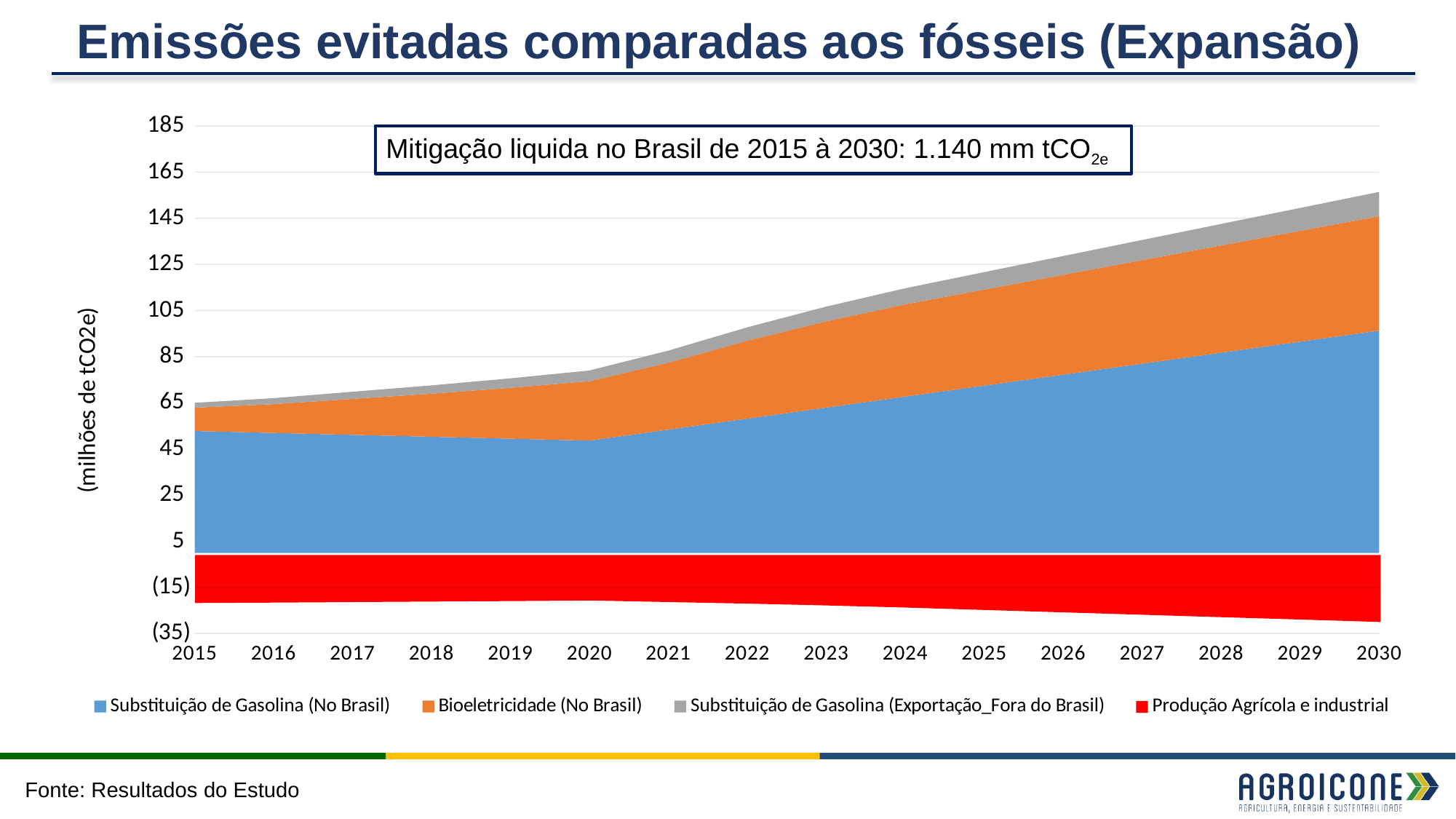
Is the value for Substituição de Gasolina (No Brasil) in 2030 greater or less than 85? greater Is the top of the stacked positive areas in 2020 greater or less than 65? greater What is the first year shown on the x axis? 2015 Is the top of the stacked positive areas in 2030 greater or less than 145? greater How many series does the legend list? 4 According to the text box on the chart, what is the net mitigation in Brazil from 2015 to 2030? 1.140 mm tCO2e Does the total of the positive stacked areas rise or fall from 2015 to 2030? Rise What is the last year shown on the x axis? 2030 How many years are shown along the x axis? 16 What kind of chart is shown on the slide? Stacked area chart What is the title of the chart? Emissões evitadas comparadas aos fósseis (Expansão) Which year has the larger total of positive avoided emissions, 2015 or 2030? 2030